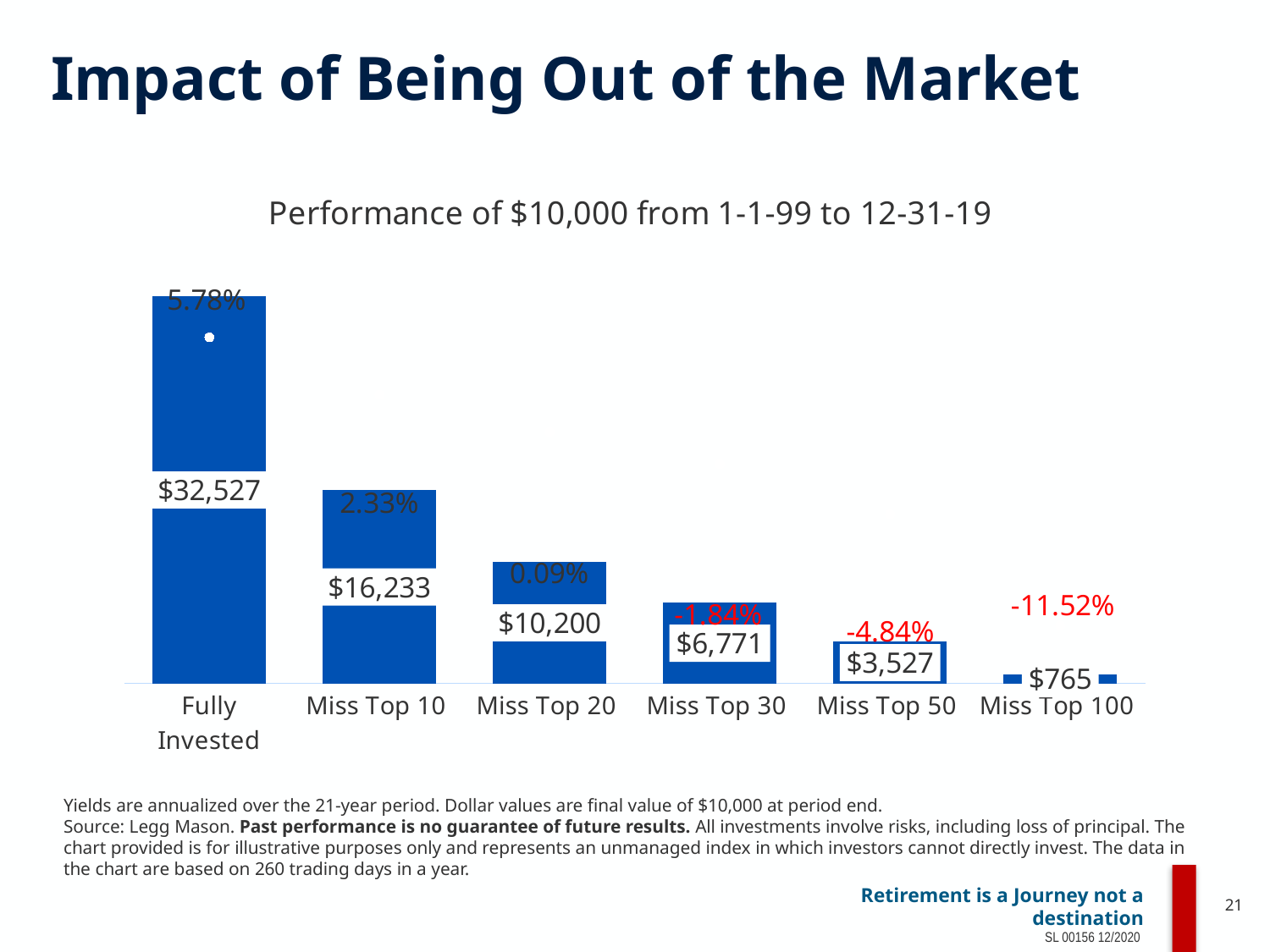
What is the final dollar value for Miss Top 100? $765 What is the final dollar value for Miss Top 10? $16,233 What kind of chart is shown on the slide? Bar chart Do the final dollar values rise or fall moving from left to right along the x axis? Fall Which category has the lowest final dollar value? Miss Top 100 What is the difference in final dollar value between Fully Invested and Miss Top 10? $16,294 What is the final dollar value for Fully Invested? $32,527 How many categories are shown on the x axis? 6 What annualized yield is shown for Miss Top 50? -4.84% Which category has the highest final dollar value? Fully Invested Which has a larger final dollar value, Miss Top 30 or Miss Top 50? Miss Top 30 What annualized yield is shown for Miss Top 20? 0.09%